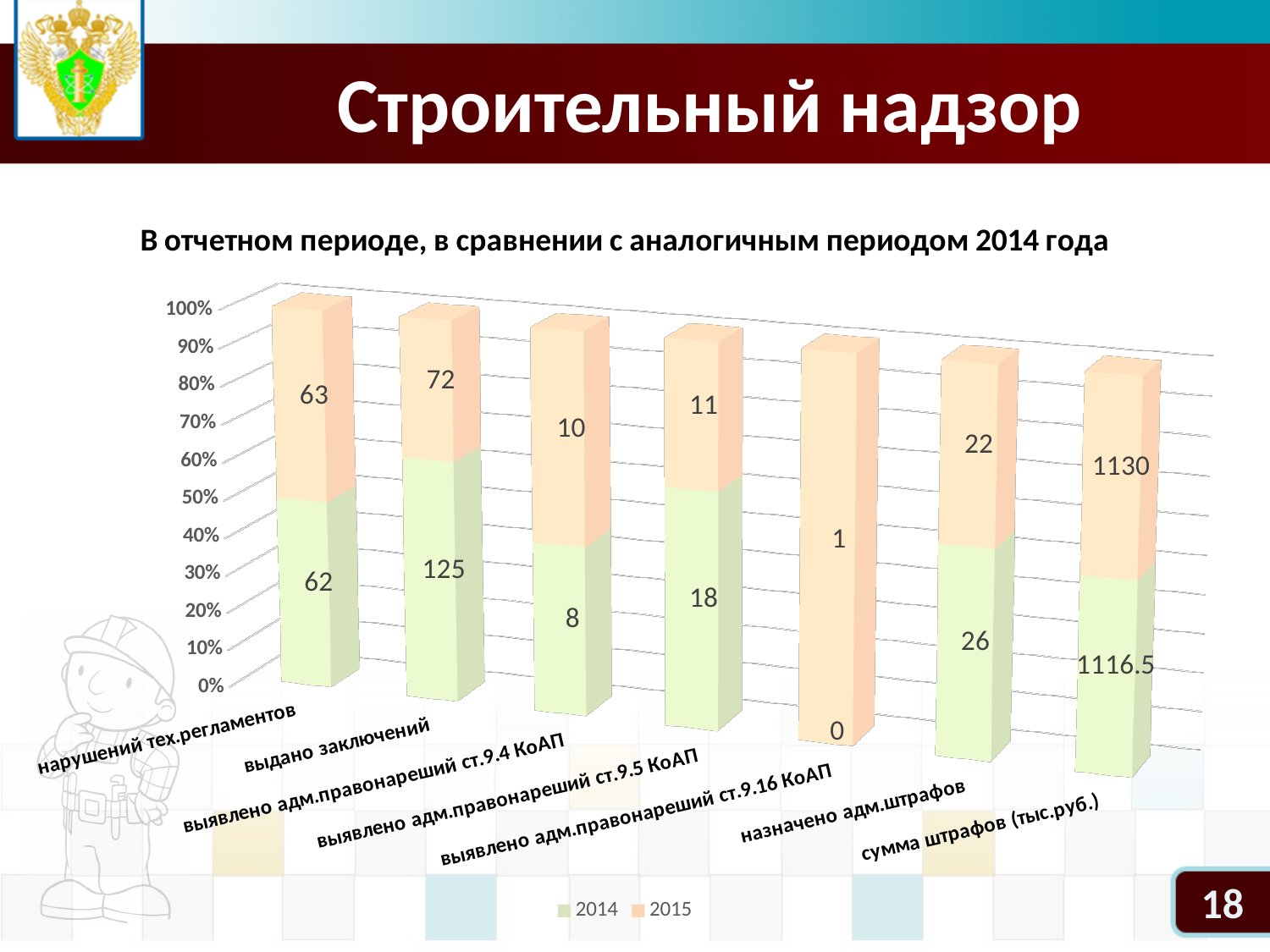
What is the 2015 value for "сумма штрафов (тыс.руб.)"? 1130 What is the 2014 value for "назначено адм.штрафов"? 26 What is the 2014 value for "выдано заключений"? 125 What is the difference between the 2014 and 2015 values for "выдано заключений"? 53 What type of chart is shown on the slide? Stacked bar chart For "выявлено адм.правонарешений ст.9.4 КоАП", which year has the larger value, 2014 or 2015? 2015 How many series does the chart legend list? 2 How many categories are shown on the x axis of the chart? 7 For "выявлено адм.правонарешений ст.9.5 КоАП", which year has the larger value, 2014 or 2015? 2014 What is the 2015 value for "нарушений тех.регламентов"? 63 What is the 2014 value for "выявлено адм.правонарешений ст.9.16 КоАП"? 0 Which category has the lowest 2014 value? выявлено адм.правонарешений ст.9.16 КоАП